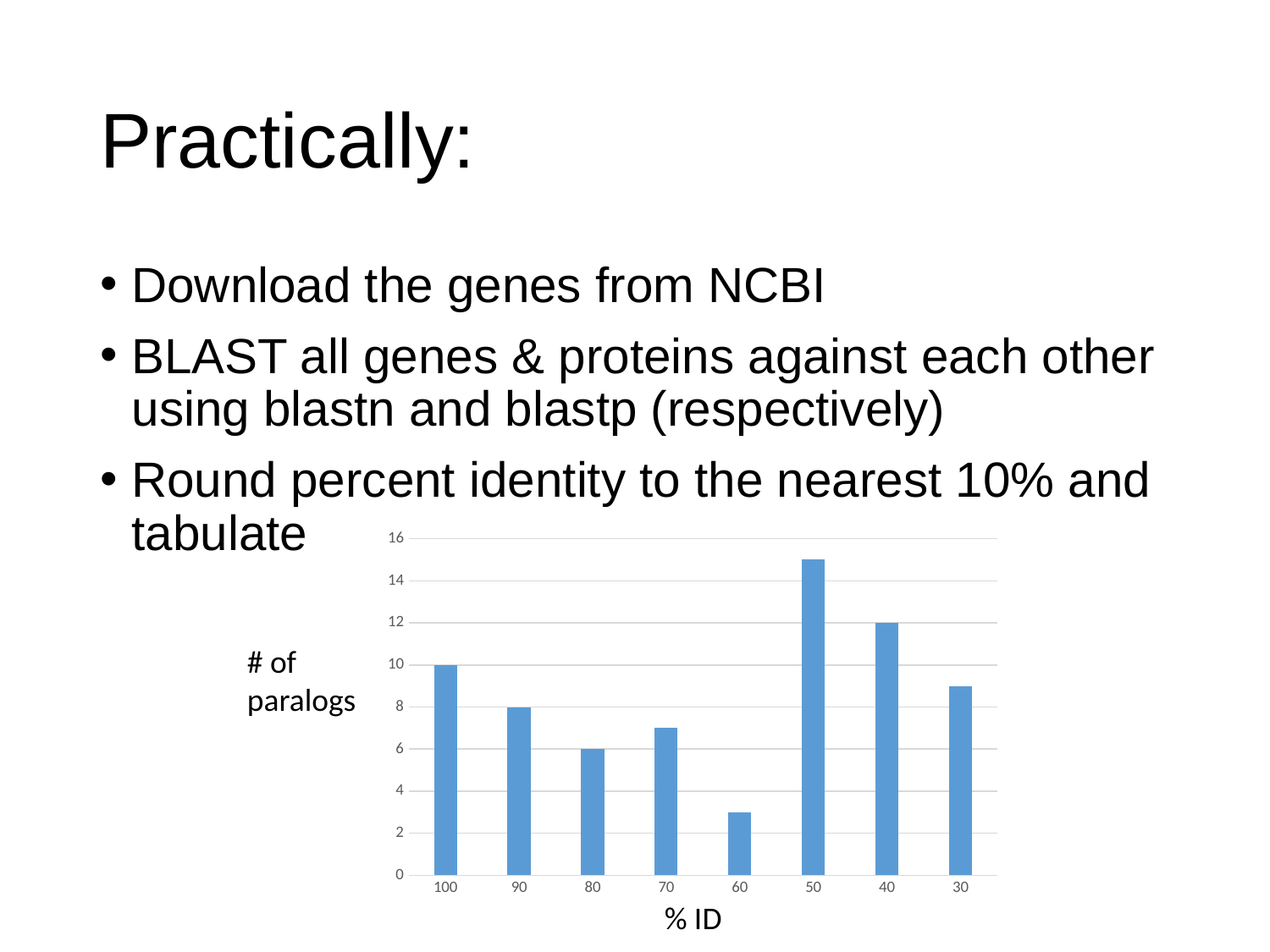
How many % ID categories are plotted on the chart? 8 What is the number of paralogs for the 40 % ID category? 12 What kind of chart is shown on the slide? bar chart Is the number of paralogs for the 60 % ID category greater or less than 4? less Is the number of paralogs for the 50 % ID category greater or less than 14? greater Which % ID category has the highest number of paralogs? 50 What is the difference in number of paralogs between the 100 and 90 % ID categories? 2 Which % ID category has the lowest number of paralogs? 60 What is the number of paralogs for the 90 % ID category? 8 What is the number of paralogs for the 100 % ID category? 10 Which has more paralogs, the 80 % ID category or the 40 % ID category? 40 What is the label on the x axis of the chart? % ID